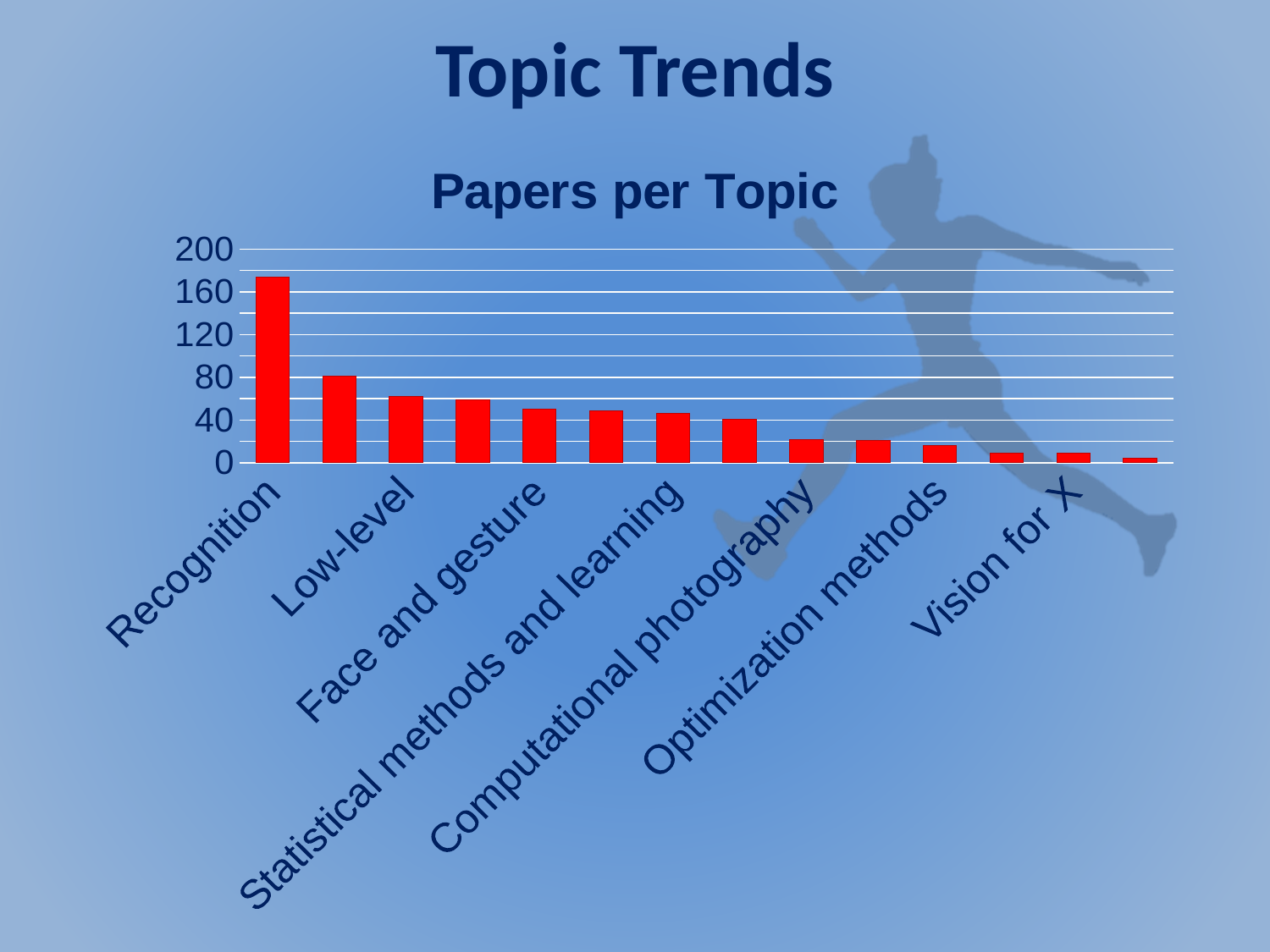
What kind of chart is shown on the slide? bar chart Which topic has the highest number of papers? Recognition Is the value for Face and gesture greater or less than 80? less Is the value for Low-level greater or less than 80? less Which has more papers, Recognition or Low-level? Recognition Is the value for Vision for X greater or less than 40? less Do the values rise or fall moving from left to right along the x axis? fall What colour are the bars in the chart? red Which has more papers, Face and gesture or Optimization methods? Face and gesture What is the title of the chart? Papers per Topic